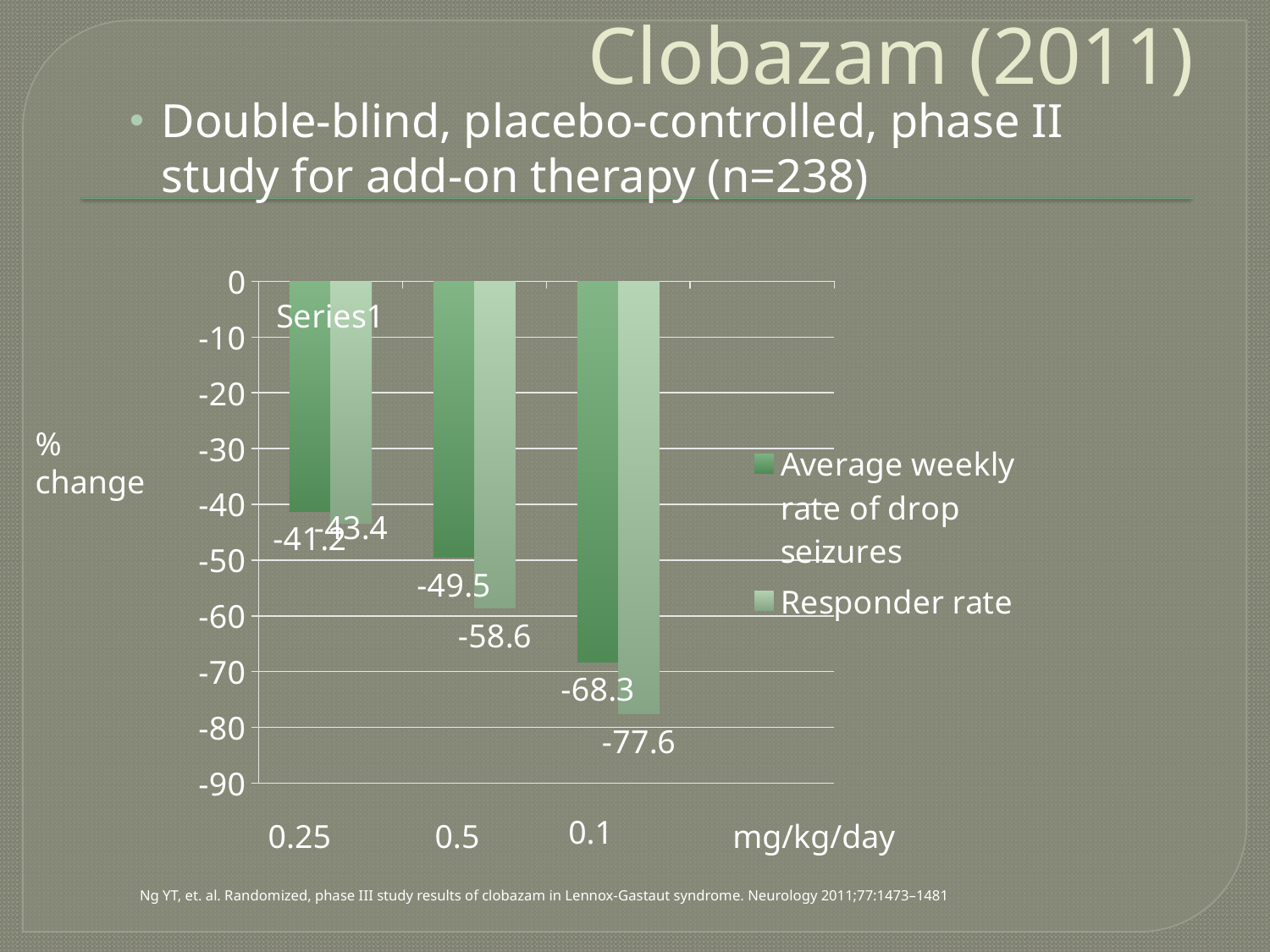
What is the value for Average weekly rate of drop seizures at 0.25 mg/kg/day? -41.2 What is the value for Average weekly rate of drop seizures at 0.1 mg/kg/day? -68.3 Do the Average weekly rate of drop seizures values become more negative or less negative moving from 0.25 to 0.1 along the x axis? more negative What label is shown on the y axis of the chart? % change Which dose category has the most negative Responder rate value? 0.1 What is the Responder rate value at 0.1 mg/kg/day? -77.6 What is the Responder rate value at 0.5 mg/kg/day? -58.6 How many dose categories are shown on the x axis of the chart? 3 How many series does the chart legend list? 2 What kind of chart is shown on the slide? bar chart What is the difference between the Responder rate and the Average weekly rate of drop seizures at 0.5 mg/kg/day? 9.1 Which dose category has the Average weekly rate of drop seizures value closest to zero? 0.25